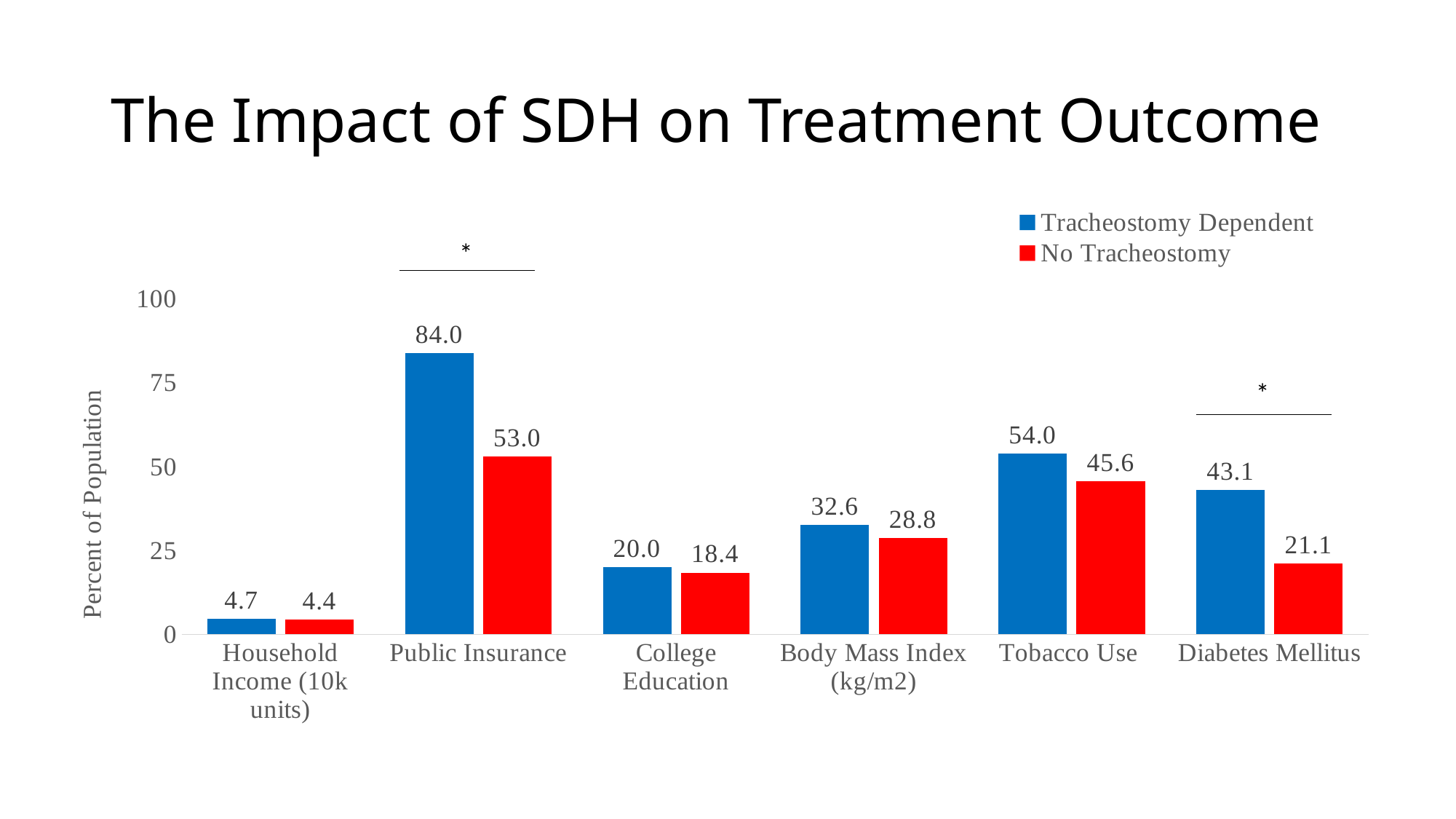
What is the No Tracheostomy value for Tobacco Use? 45.6 How many series does the legend list? 2 What kind of chart is shown on the slide? Bar chart Is the Tracheostomy Dependent value for Tobacco Use greater or less than 50? greater What is the difference between the Tracheostomy Dependent and No Tracheostomy values for Public Insurance? 31.0 Which category has the highest Tracheostomy Dependent value? Public Insurance What is the No Tracheostomy value for Diabetes Mellitus? 21.1 What is the Tracheostomy Dependent value for Public Insurance? 84.0 How many categories are shown on the x axis? 6 What is the difference between the Tracheostomy Dependent and No Tracheostomy values for Diabetes Mellitus? 22.0 Which category has the lowest No Tracheostomy value? Household Income (10k units) Which is larger for Body Mass Index (kg/m2): the Tracheostomy Dependent value or the No Tracheostomy value? Tracheostomy Dependent